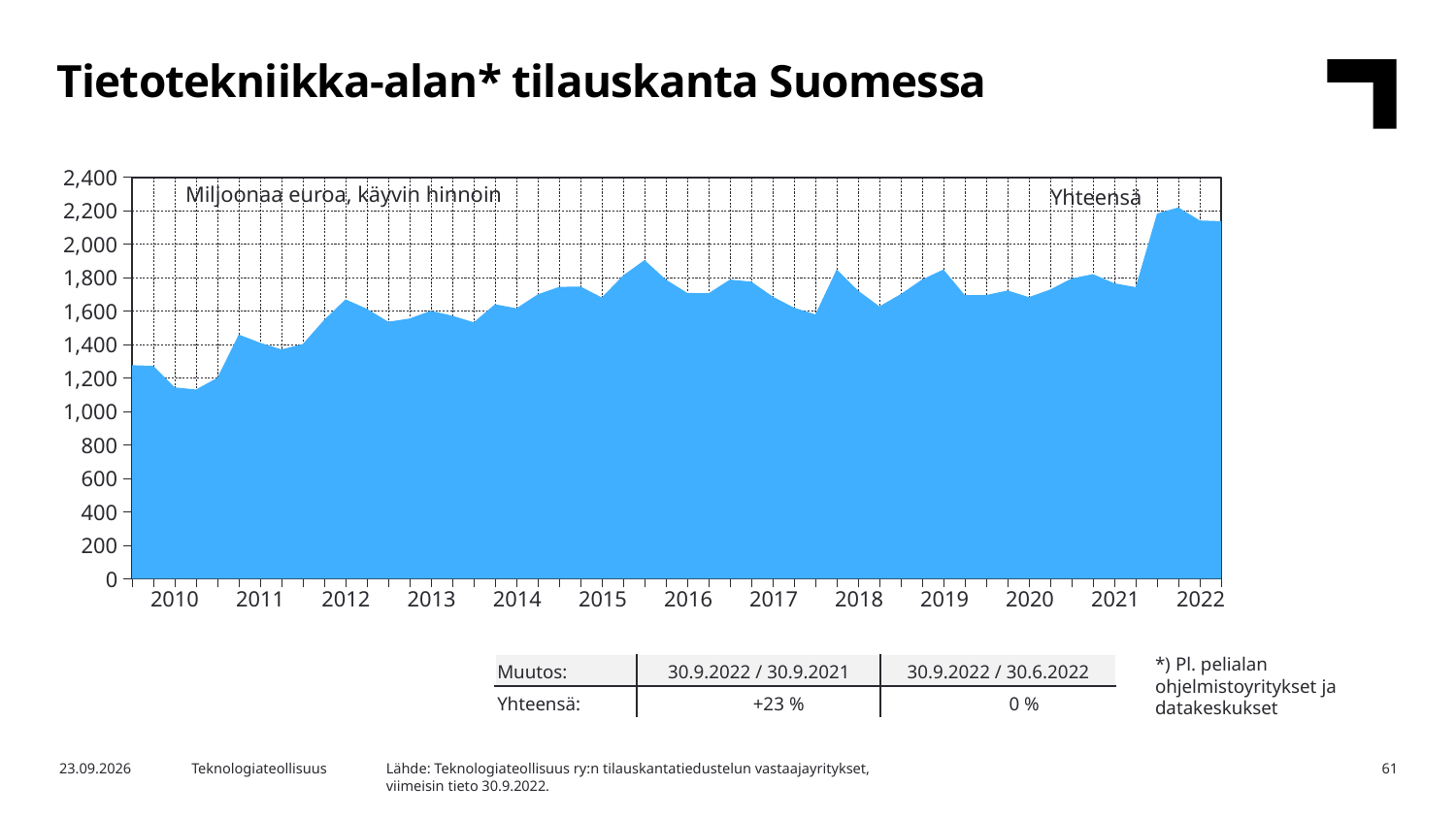
Is the peak value in 2015 greater or less than 1,800? greater How many years are labelled on the x axis? 13 Does the series generally rise or fall from 2010 to 2022? Rise What is the title of the chart on the slide? Tietotekniikka-alan* tilauskanta Suomessa Is the value at the end of the series in 2022 greater or less than 2,000? greater What is the highest value shown on the y axis? 2,400 Is the value at the start of 2019 greater or less than 1,600? greater What unit label is printed inside the chart area? Miljoonaa euroa, käyvin hinnoin What kind of chart is shown on the slide? Area chart Which is larger, the value in 2022 or the value in 2010? 2022